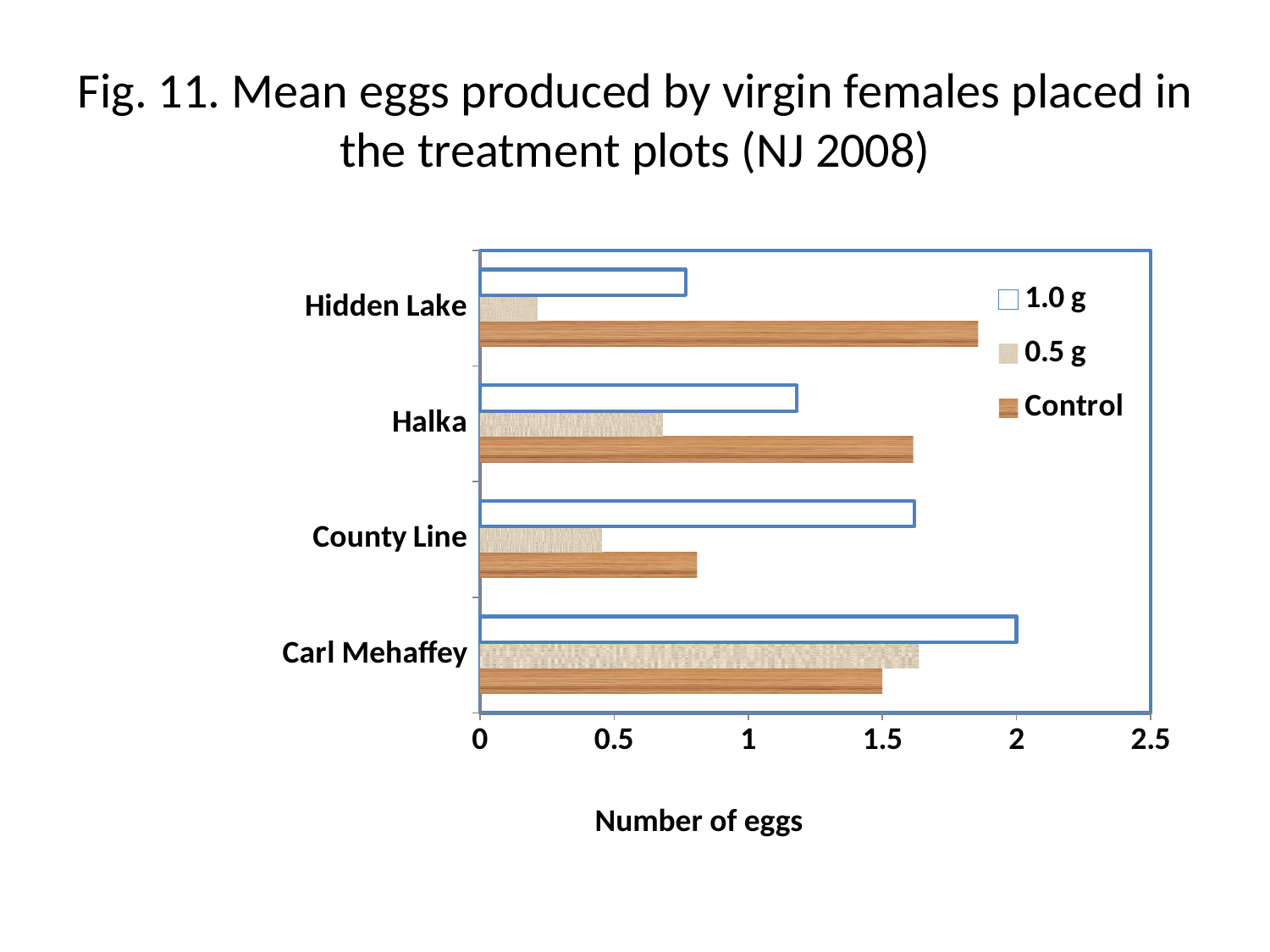
Which plot has the highest 1.0 g value? Carl Mehaffey Is the Control value for Hidden Lake greater or less than 1.5? greater How many series does the legend list? 3 What kind of chart is shown on the slide? bar chart How many treatment plots (categories) are shown on the chart? 4 Is the 1.0 g value for Halka greater or less than 1? greater What is the label of the horizontal axis? Number of eggs Which plot has the highest Control value? Hidden Lake Which plot has the lowest Control value? County Line Which plot has the lowest 0.5 g value? Hidden Lake Is the 0.5 g value for County Line greater or less than 0.5? less For County Line, which is larger: the 1.0 g value or the Control value? 1.0 g